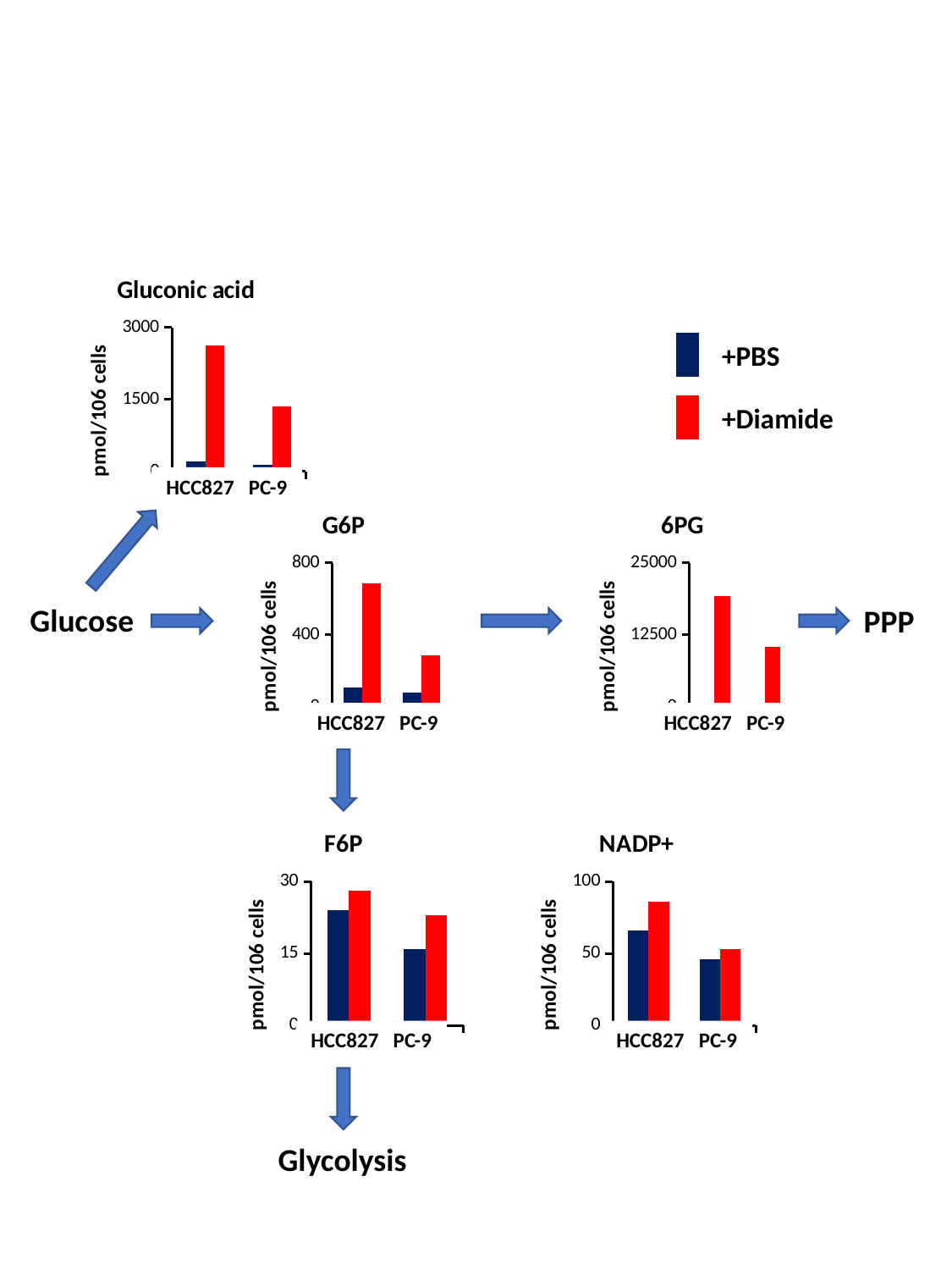
In the 6PG chart, is the value for PC-9 greater or less than 12500? less In the F6P chart, which bar is the highest? HCC827 +Diamide What kind of chart is the G6P chart? bar chart In the Gluconic acid chart, how many cell lines are shown on the x axis? 2 In the 6PG chart, is the value for HCC827 greater or less than 12500? greater In the NADP+ chart, is the +PBS value for PC-9 greater or less than 50? less In the G6P chart, which cell line has the higher +Diamide value, HCC827 or PC-9? HCC827 How many series does the legend list? 2 Which colour represents +Diamide in the legend? red